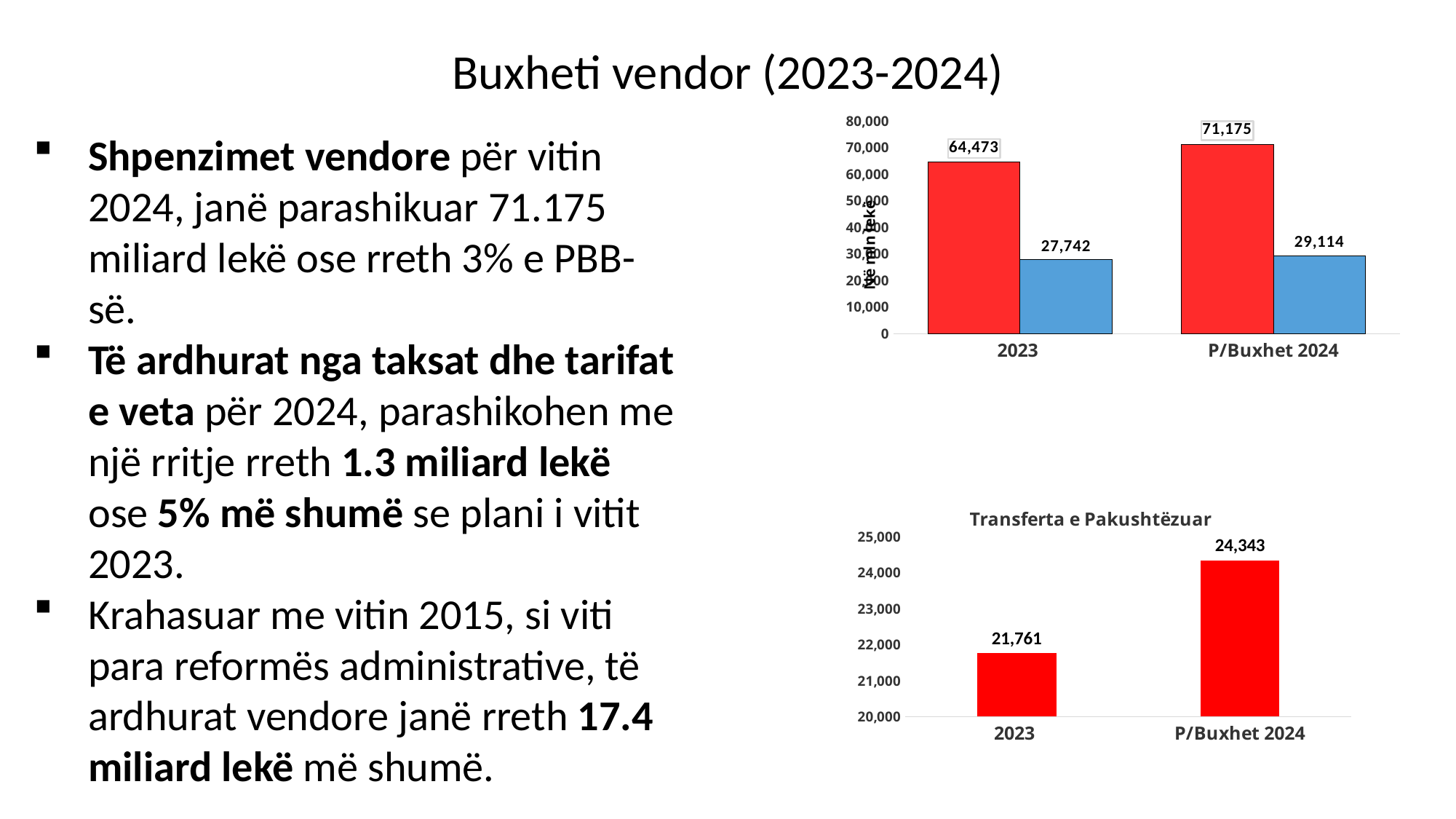
In the top chart, what is the value of the blue bar for P/Buxhet 2024? 29,114 How many categories are shown on the x axis of the top chart? 2 What kind of chart is the top chart? bar chart In the chart titled 'Transferta e Pakushtëzuar', what is the difference between the P/Buxhet 2024 value and the 2023 value? 2,582 In the chart titled 'Transferta e Pakushtëzuar', do the values rise or fall from 2023 to P/Buxhet 2024? rise In the top chart, what is the value of the red bar for 2023? 64,473 In the top chart, for 2023, which bar is larger, the red one or the blue one? the red one In the chart titled 'Transferta e Pakushtëzuar', what is the value for 2023? 21,761 In the chart titled 'Transferta e Pakushtëzuar', what is the value for P/Buxhet 2024? 24,343 In the top chart, by how much does the red bar for P/Buxhet 2024 exceed the red bar for 2023? 6,702 In the top chart, what is the value of the red bar for P/Buxhet 2024? 71,175 What is the title of the bottom chart on the slide? Transferta e Pakushtëzuar